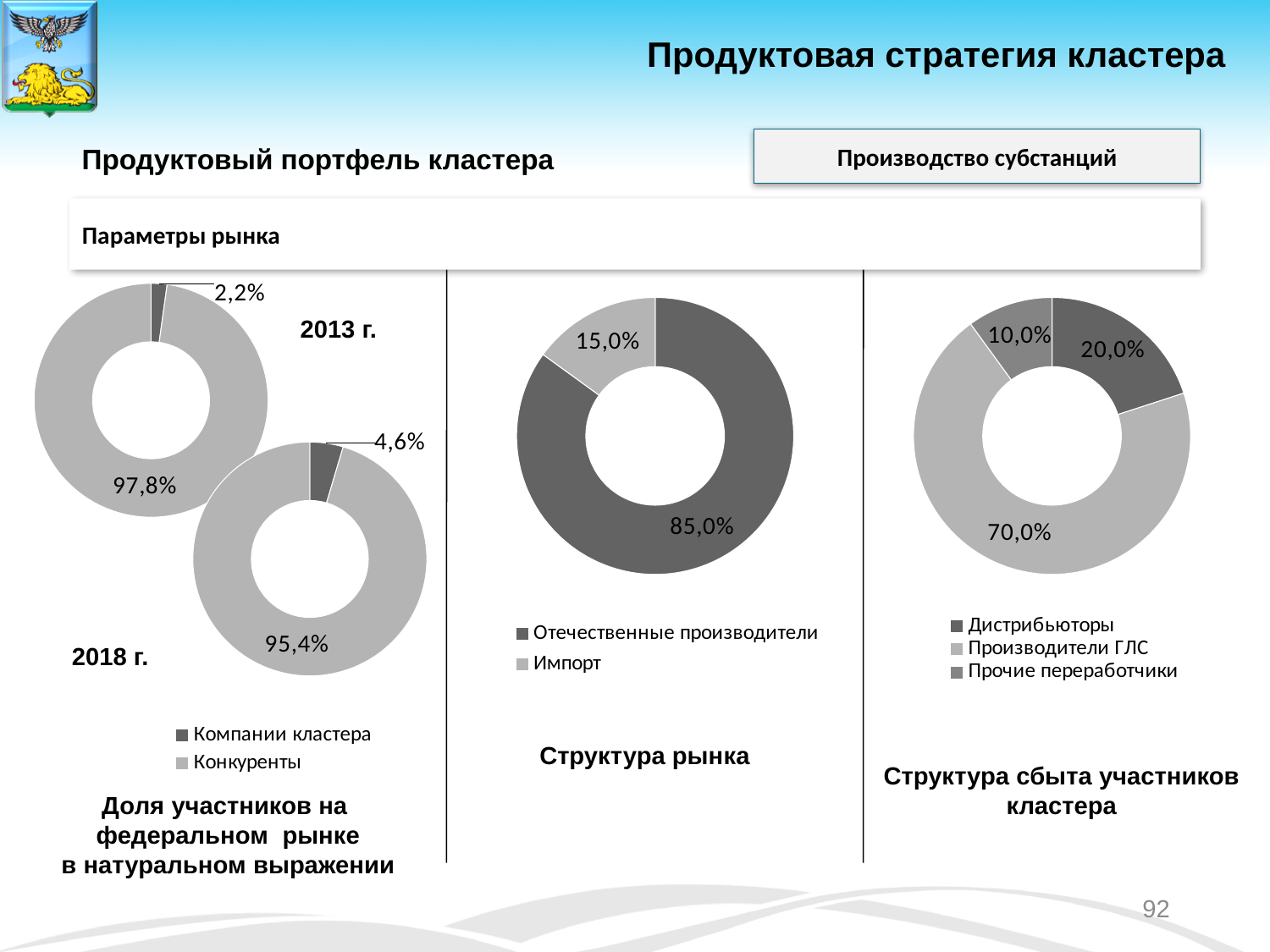
In the 2013 donut chart on the left, what is the share for Конкуренты? 97,8% In the Структура рынка chart, what is the share for Отечественные производители? 85,0% In the Структура рынка chart, which category has the larger share? Отечественные производители Comparing the left-hand charts, by how many percentage points did the share of Компании кластера change from 2013 to 2018? 2,4 In the 2013 donut chart on the left (Доля участников на федеральном рынке в натуральном выражении), what is the share for Компании кластера? 2,2% In the Структура сбыта участников кластера chart, what is the share for Производители ГЛС? 70,0% In the Структура сбыта участников кластера chart, which category has the smallest share? Прочие переработчики In the Структура сбыта участников кластера chart, how many categories does the legend list? 3 In the 2018 donut chart on the left, what is the share for Компании кластера? 4,6% What type of chart is the Структура рынка chart? Donut (pie) chart In the 2018 donut chart on the left, what is the share for Конкуренты? 95,4% In the Структура рынка chart, what is the share for Импорт? 15,0%